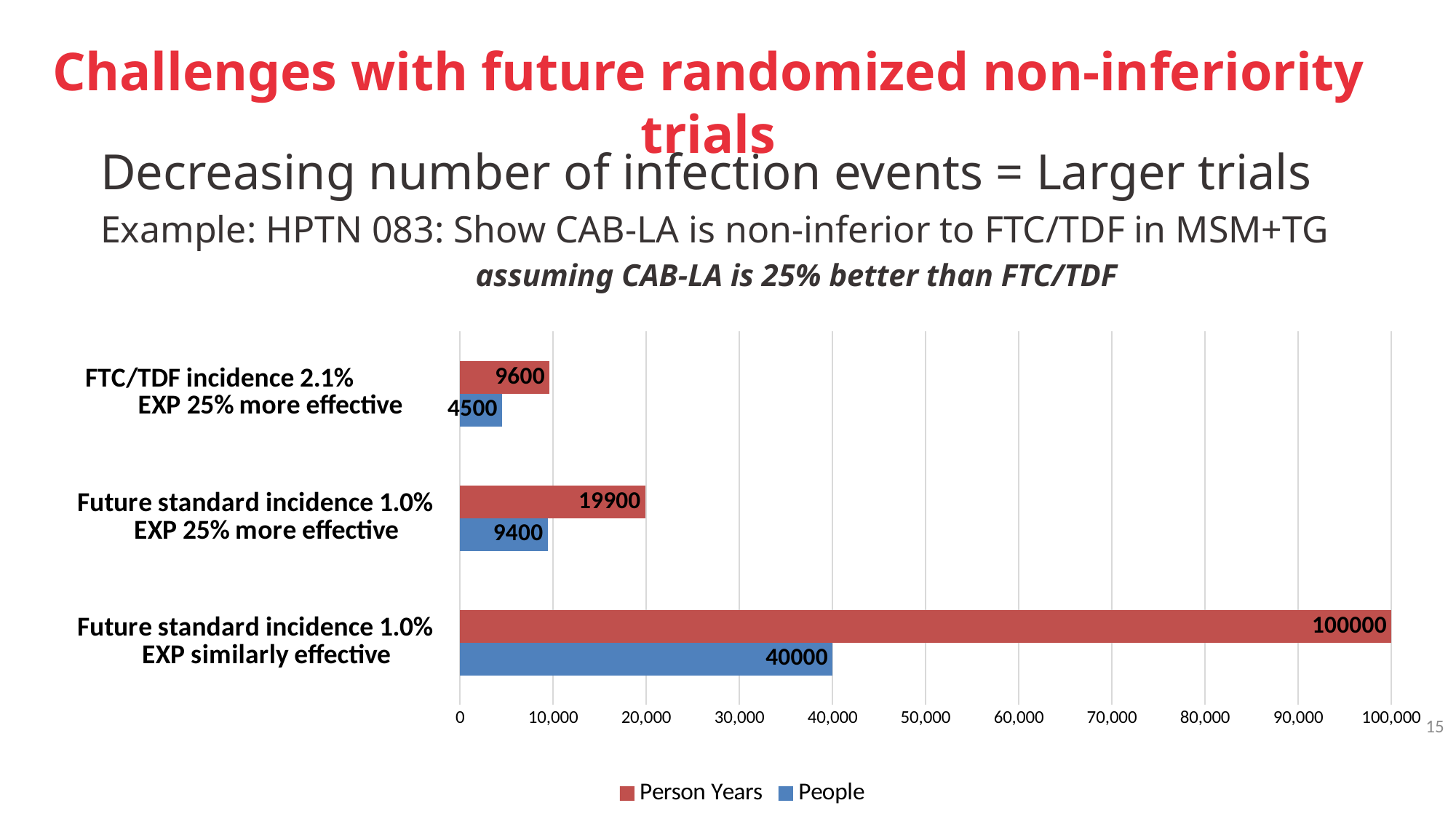
Which is larger: the People value for 'Future standard incidence 1.0% EXP similarly effective' or the Person Years value for 'Future standard incidence 1.0% EXP 25% more effective'? People value for 'Future standard incidence 1.0% EXP similarly effective' How many categories are shown on the chart? 3 What is the difference between the Person Years and People values for 'Future standard incidence 1.0% EXP 25% more effective'? 10500 Is the Person Years value for 'Future standard incidence 1.0% EXP 25% more effective' greater or less than 10,000? greater Which category has the highest People value? Future standard incidence 1.0% EXP similarly effective What is the People value for 'FTC/TDF incidence 2.1% EXP 25% more effective'? 4500 What kind of chart is shown on the slide? bar chart What is the People value for 'Future standard incidence 1.0% EXP 25% more effective'? 9400 Which category has the lowest Person Years value? FTC/TDF incidence 2.1% EXP 25% more effective How many series does the legend list? 2 What is the Person Years value for 'FTC/TDF incidence 2.1% EXP 25% more effective'? 9600 What is the Person Years value for 'Future standard incidence 1.0% EXP similarly effective'? 100000